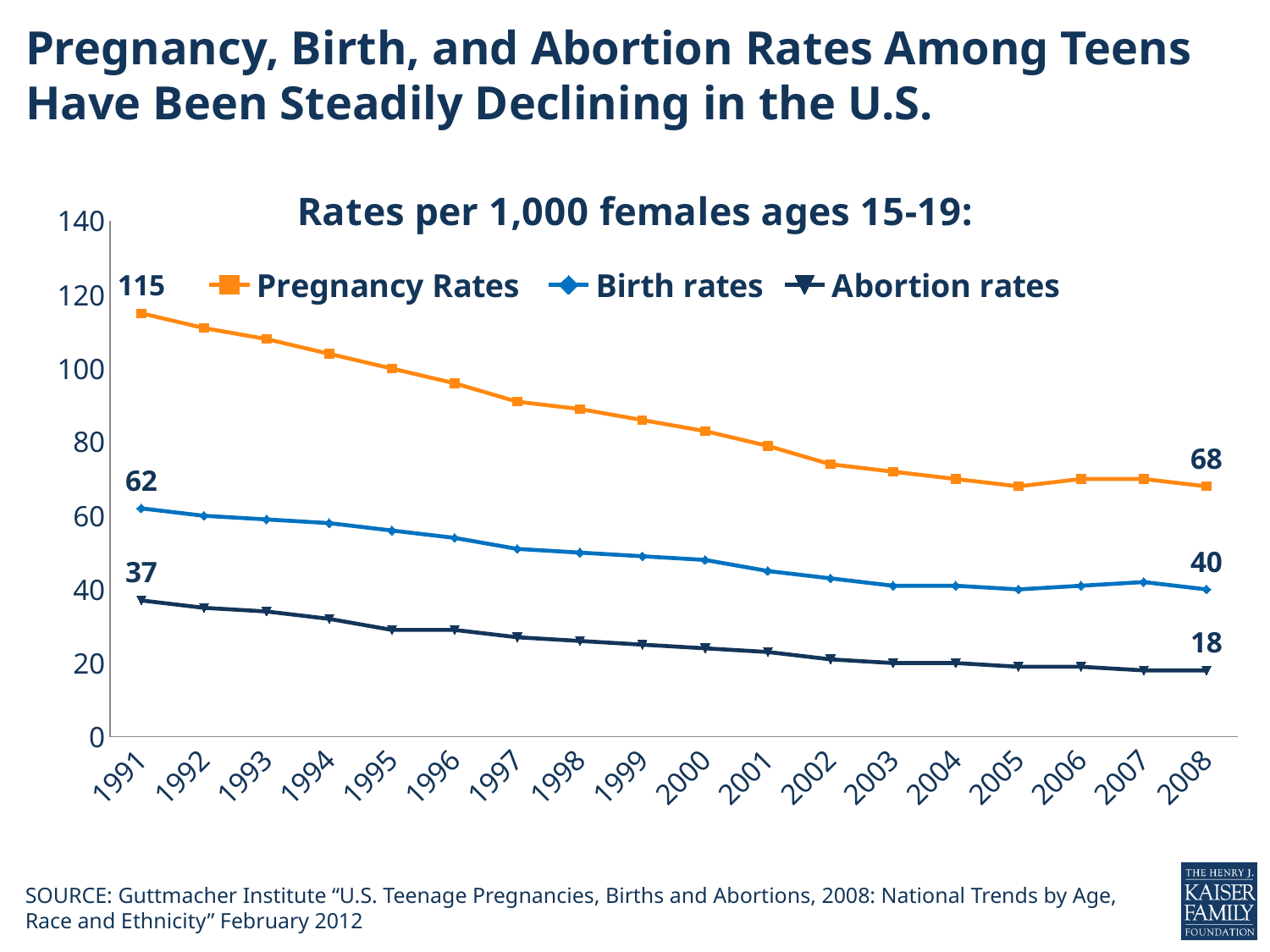
By how much did the abortion rate fall from 1991 to 2008? 19 Which series has the highest values across the chart? Pregnancy Rates Which series has the lowest values across the chart? Abortion rates What was the pregnancy rate in 2008? 68 Is the pregnancy rate in 2000 greater or less than 80? greater What kind of chart is shown? Line chart What was the pregnancy rate in 1991? 115 What was the abortion rate in 1991? 37 By how much did the pregnancy rate fall from 1991 to 2008? 47 How many series does the legend list? 3 What was the birth rate in 2008? 40 Do the rates rise or fall from 1991 to 2008? Fall